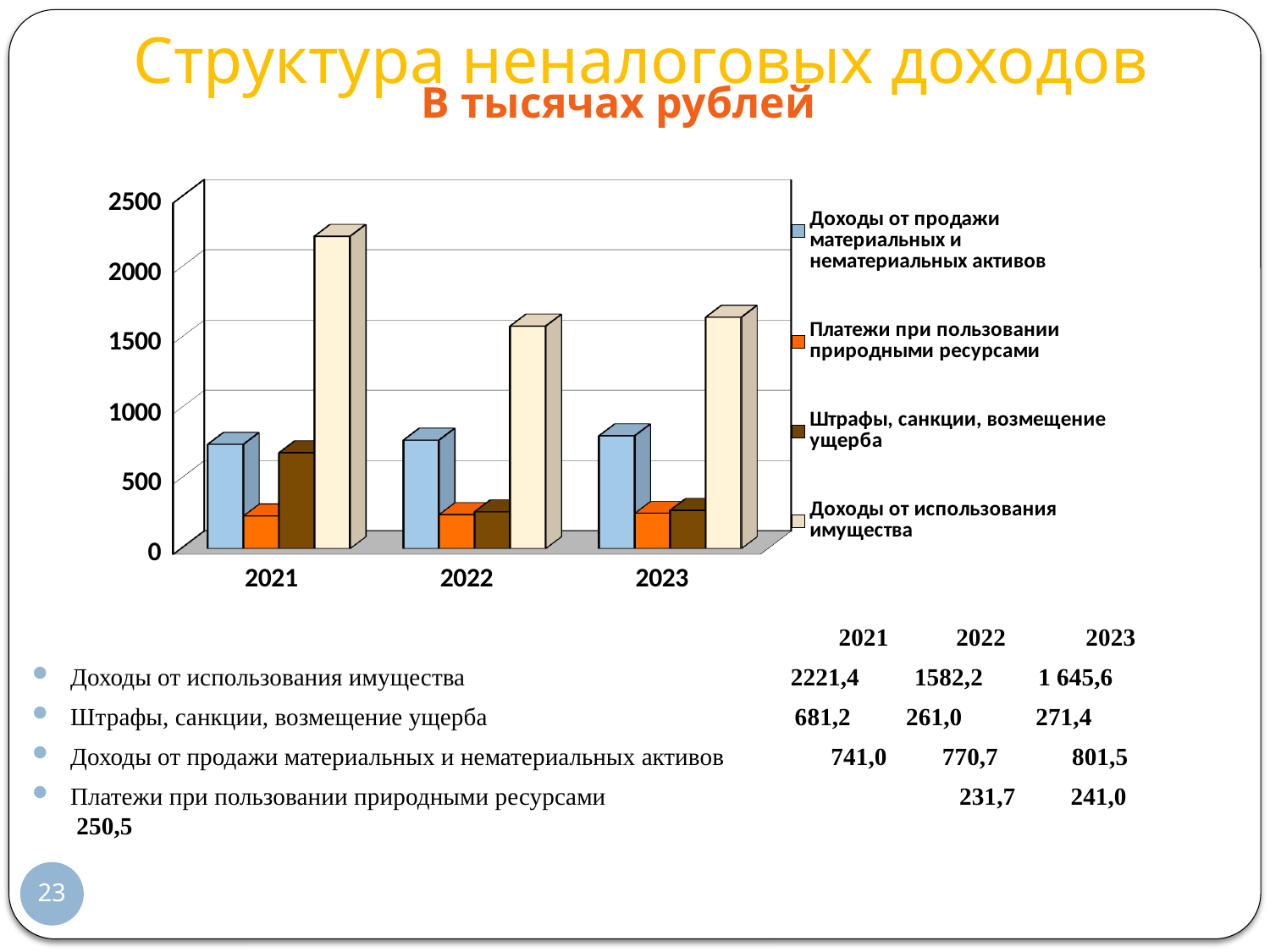
In which year is Доходы от использования имущества the highest? 2021 What is the title of the slide's chart? Структура неналоговых доходов What is the value of Доходы от продажи материальных и нематериальных активов in 2023? 801,5 How many series does the chart legend list? 4 Do the values for Доходы от продажи материальных и нематериальных активов rise or fall from 2021 to 2023? rise Is the value for Доходы от использования имущества in 2022 greater or less than 1500? greater What is the difference between Доходы от использования имущества in 2021 and in 2022? 639,2 How many years are shown along the x axis of the chart? 3 What is the value of Доходы от использования имущества in 2021? 2221,4 What type of chart is shown on the slide? bar chart Which year has the larger value for Штрафы, санкции, возмещение ущерба: 2021 or 2022? 2021 What is the value of Штрафы, санкции, возмещение ущерба in 2022? 261,0